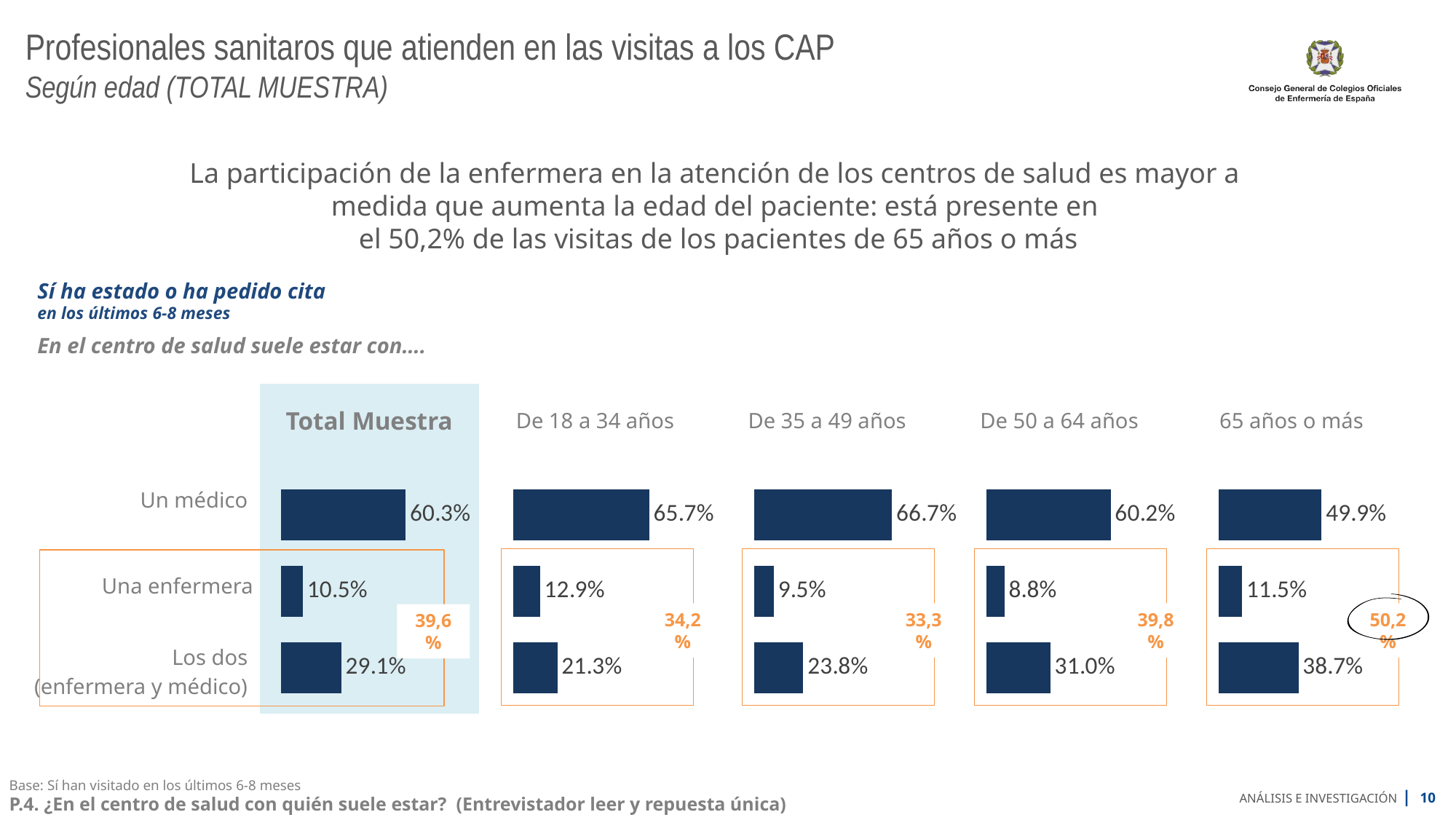
What is the orange highlighted figure shown for the '65 años o más' chart? 50,2% What kind of chart is used for the 'Total Muestra' data? Bar chart In the '65 años o más' chart, what is the value for 'Los dos (enfermera y médico)'? 38.7% In the 'De 35 a 49 años' chart, which category has the highest value? Un médico In the 'De 50 a 64 años' chart, what is the value for 'Una enfermera'? 8.8% In the '65 años o más' chart, what is the difference between 'Un médico' and 'Los dos (enfermera y médico)'? 11.2% In the 'Total Muestra' chart, what is the value for 'Un médico'? 60.3% In the 'De 18 a 34 años' chart, what is the value for 'Una enfermera'? 12.9% In the 'De 18 a 34 años' chart, which is larger: 'Una enfermera' or 'Los dos (enfermera y médico)'? Los dos (enfermera y médico) In the 'De 50 a 64 años' chart, which category has the lowest value? Una enfermera Across the age-group charts from 'De 18 a 34 años' to '65 años o más', does the value for 'Un médico' rise or fall overall? Fall How many categories does each bar chart on the slide show? 3